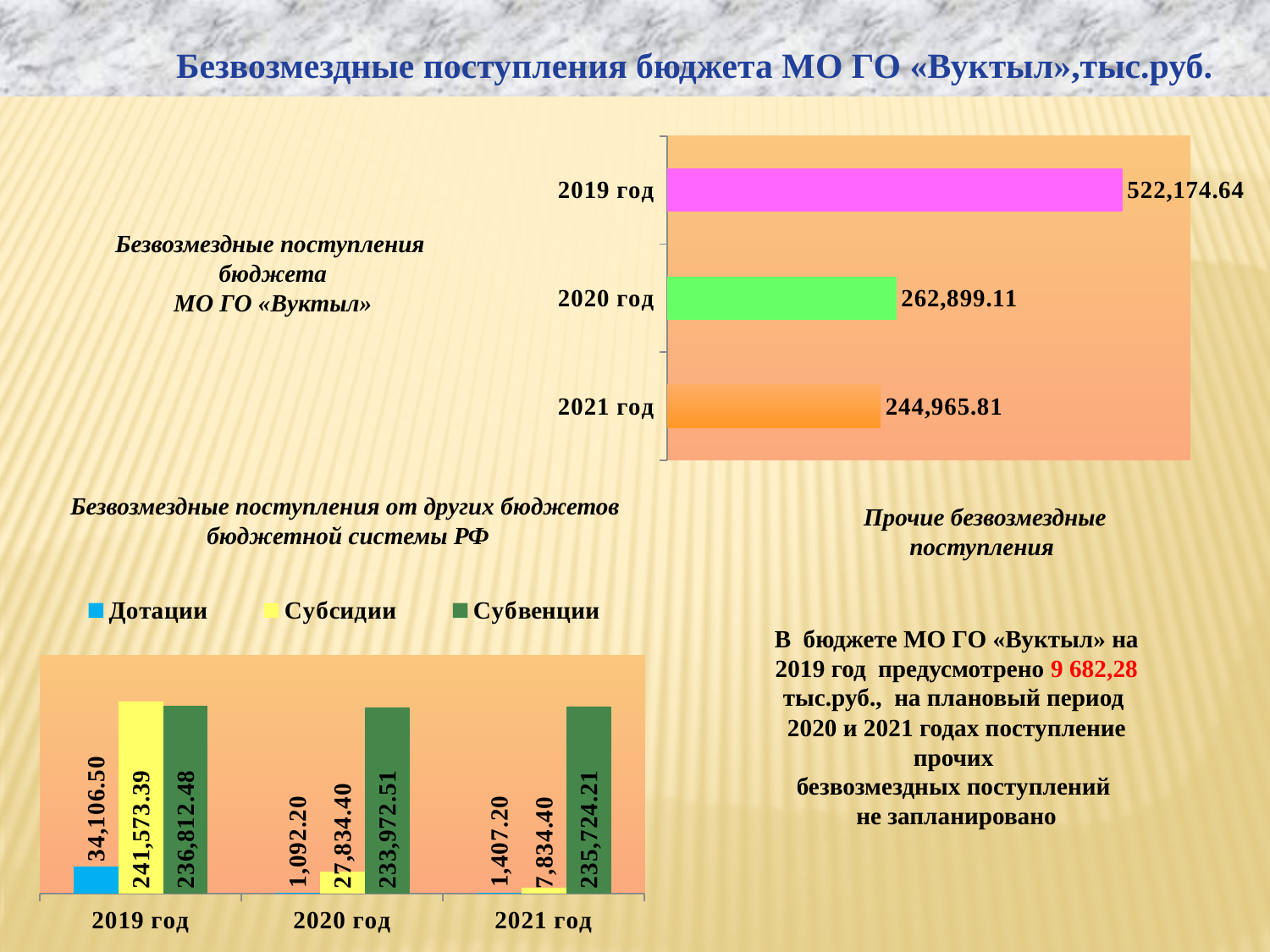
In the bottom chart «Безвозмездные поступления от других бюджетов бюджетной системы РФ», which is larger for 2021 год: Субсидии or Субвенции? Субвенции In the top chart «Безвозмездные поступления бюджета МО ГО «Вуктыл»», what is the value for 2021 год? 244,965.81 In the top chart «Безвозмездные поступления бюджета МО ГО «Вуктыл»», which year has the highest value? 2019 год In the bottom chart «Безвозмездные поступления от других бюджетов бюджетной системы РФ», what is the difference between Субсидии in 2019 год and 2020 год? 213,738.99 In the top chart «Безвозмездные поступления бюджета МО ГО «Вуктыл»», do the values rise or fall from 2019 год to 2021 год? fall In the bottom chart «Безвозмездные поступления от других бюджетов бюджетной системы РФ», what is the value of Субсидии for 2020 год? 27,834.40 In the bottom chart «Безвозмездные поступления от других бюджетов бюджетной системы РФ», which year has the lowest value of Дотации? 2020 год In the bottom chart «Безвозмездные поступления от других бюджетов бюджетной системы РФ», how many series does the legend list? 3 In the top chart «Безвозмездные поступления бюджета МО ГО «Вуктыл»», what is the value for 2019 год? 522,174.64 In the bottom chart «Безвозмездные поступления от других бюджетов бюджетной системы РФ», what is the value of Дотации for 2019 год? 34,106.50 What kind of chart is the top chart «Безвозмездные поступления бюджета МО ГО «Вуктыл»»? bar chart In the top chart «Безвозмездные поступления бюджета МО ГО «Вуктыл»», what is the difference between the 2019 год and 2020 год values? 259,275.53